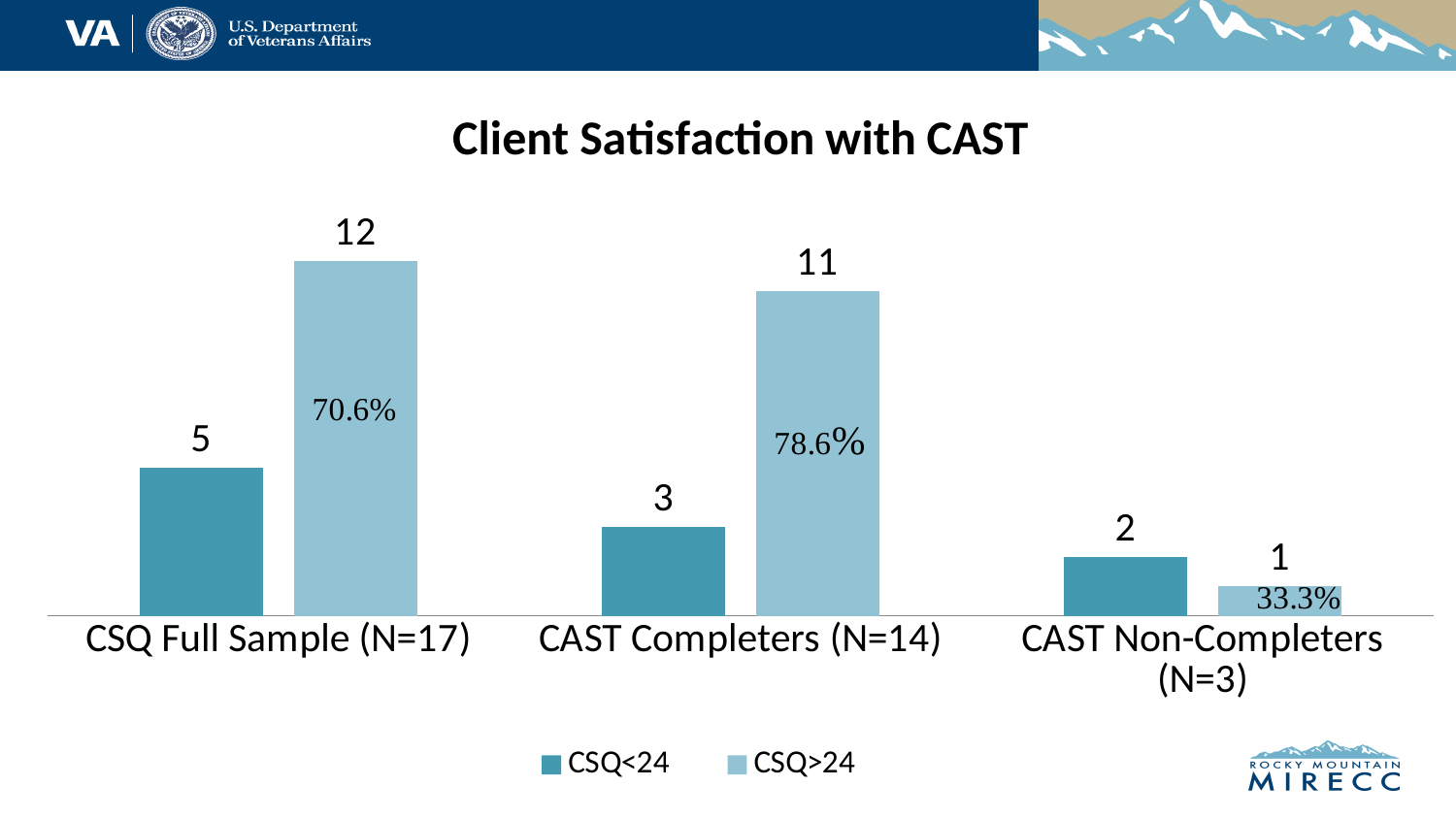
Which category has the lowest CSQ<24 value? CAST Non-Completers (N=3) What is the difference between the CSQ>24 and CSQ<24 values for CSQ Full Sample (N=17)? 7 What percentage is shown on the CSQ>24 bar for CSQ Full Sample (N=17)? 70.6% What percentage is shown on the CSQ>24 bar for CAST Completers (N=14)? 78.6% For CAST Non-Completers (N=3), which is larger, CSQ<24 or CSQ>24? CSQ<24 What is the CSQ>24 value for CSQ Full Sample (N=17)? 12 What is the CSQ<24 value for CAST Completers (N=14)? 3 Which category has the highest CSQ>24 value? CSQ Full Sample (N=17) How many series does the legend list? 2 What is the CSQ>24 value for CAST Non-Completers (N=3)? 1 How many categories are shown on the x axis? 3 What type of chart is shown on the slide? Bar chart